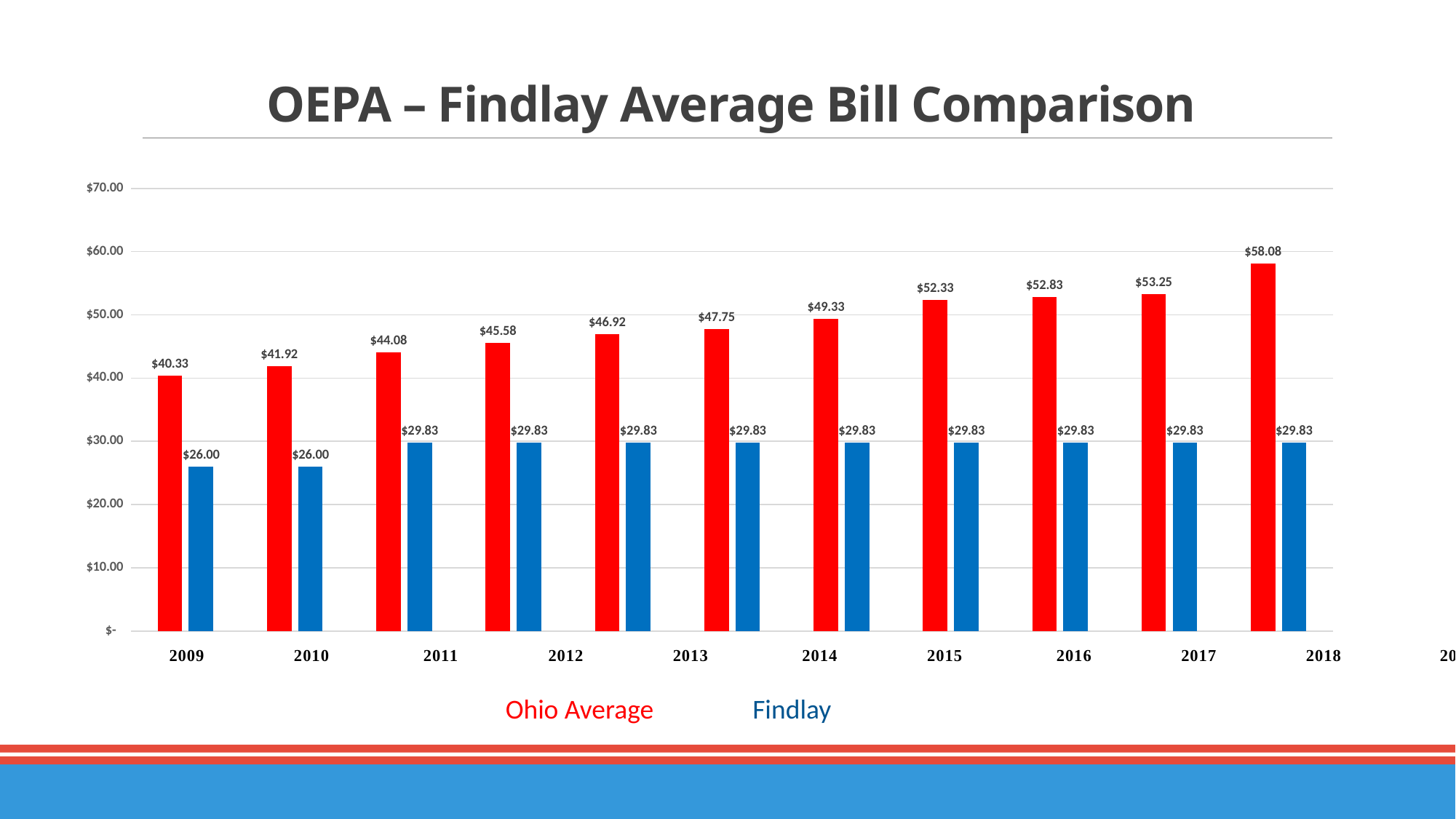
What is the Ohio Average value for the leftmost pair of bars (2009)? $40.33 What kind of chart is shown on the slide? bar chart Which series has the larger value in the rightmost pair of bars, Ohio Average or Findlay? Ohio Average Is the rightmost Ohio Average bar greater or less than $50.00? greater How many series does the legend list? 2 Do the Ohio Average values rise or fall from left to right along the x axis? rise What is the highest Ohio Average value shown on the chart? $58.08 What is the Findlay value for the leftmost pair of bars (2009)? $26.00 Which colour represents the Ohio Average series? red What is the lowest Findlay value shown on the chart? $26.00 What is the difference between the Ohio Average and Findlay values in the leftmost pair of bars ($40.33 and $26.00)? $14.33 What is the difference between the Ohio Average and Findlay values in the rightmost pair of bars ($58.08 and $29.83)? $28.25